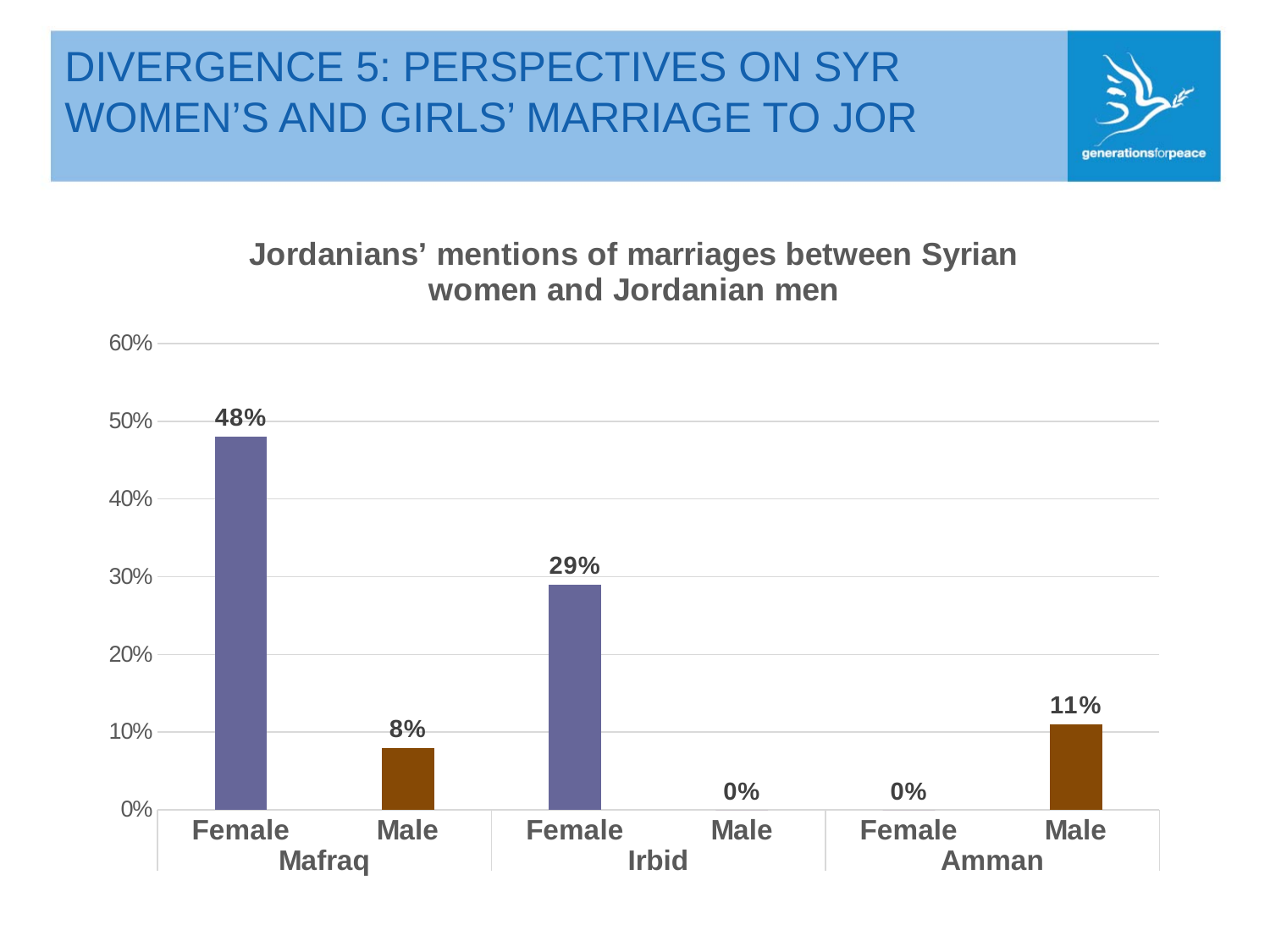
What is the difference between the Female values for Mafraq and Irbid? 19% What is the value for Female in Irbid? 29% Which group has the highest value on the chart? Female, Mafraq Which is larger, the Male value in Amman or the Male value in Mafraq? Male in Amman What is the value for Male in Mafraq? 8% What is the value for Female in Mafraq? 48% What is the difference between the Female and Male values in Mafraq? 40% What is the value for Male in Amman? 11% What kind of chart is shown on the slide? Bar chart How many bars have a value of 0%? 2 Is the value for Female in Irbid greater or less than 20%? greater How many cities are shown on the x axis? 3